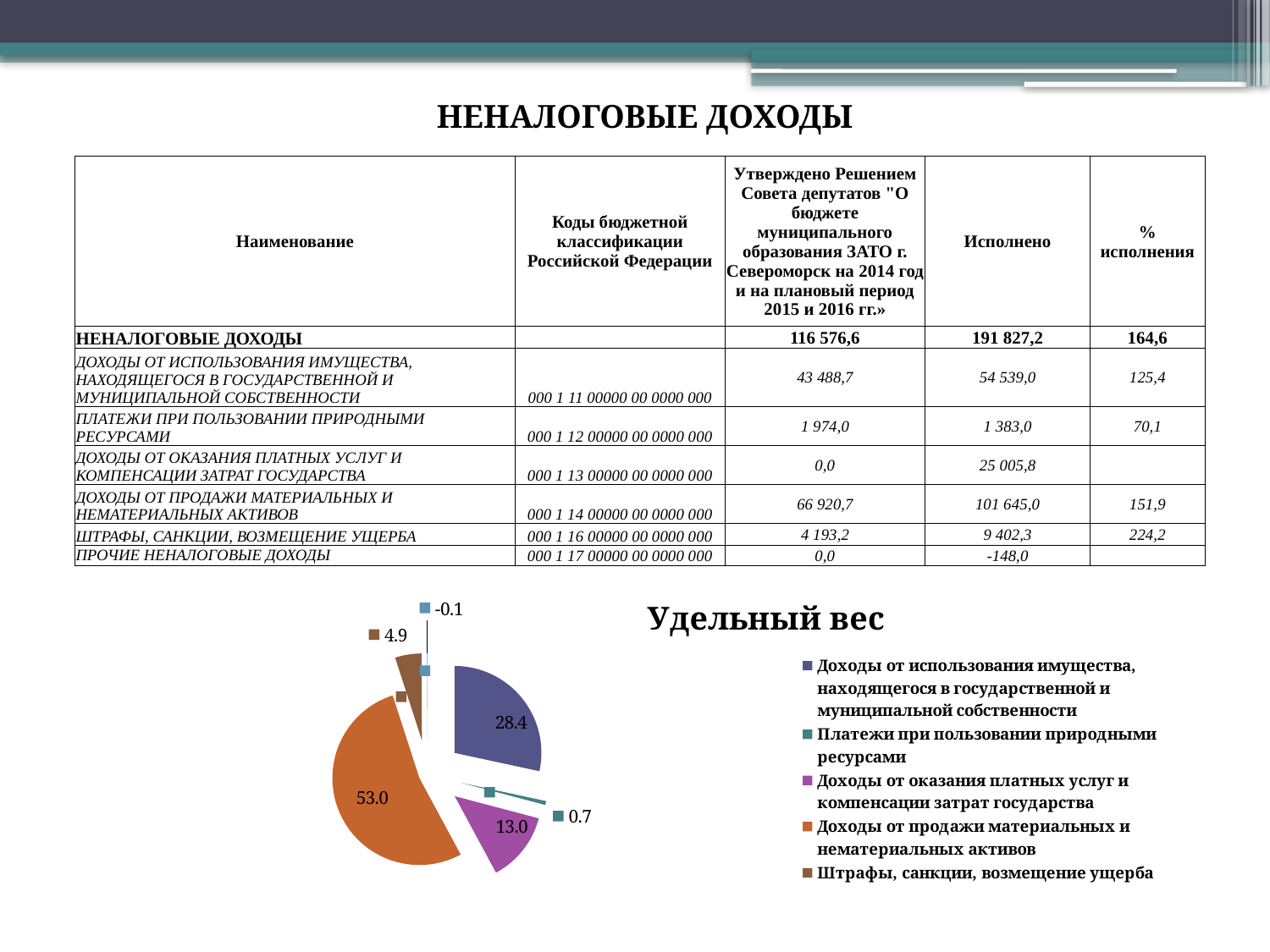
How many entries does the legend of the pie chart "Удельный вес" list? 5 What colour is the largest slice in the pie chart "Удельный вес"? orange In the pie chart "Удельный вес", what is the value for "Доходы от оказания платных услуг и компенсации затрат государства"? 13.0 What kind of chart is shown under the title "Удельный вес"? pie chart In the pie chart "Удельный вес", what is the value for "Платежи при пользовании природными ресурсами"? 0.7 In the pie chart "Удельный вес", what is the value for "Доходы от использования имущества, находящегося в государственной и муниципальной собственности"? 28.4 In the pie chart "Удельный вес", what is the difference between the values 53.0 and 28.4? 24.6 In the pie chart "Удельный вес", which is larger: the slice for "Доходы от использования имущества" or the slice for "Доходы от оказания платных услуг"? Доходы от использования имущества In the pie chart "Удельный вес", what is the value for "Доходы от продажи материальных и нематериальных активов"? 53.0 In the pie chart "Удельный вес", what is the value for "Штрафы, санкции, возмещение ущерба"? 4.9 In the pie chart "Удельный вес", which category has the largest slice? Доходы от продажи материальных и нематериальных активов In the pie chart "Удельный вес", what is the difference between the values for "Доходы от оказания платных услуг" and "Штрафы, санкции, возмещение ущерба"? 8.1